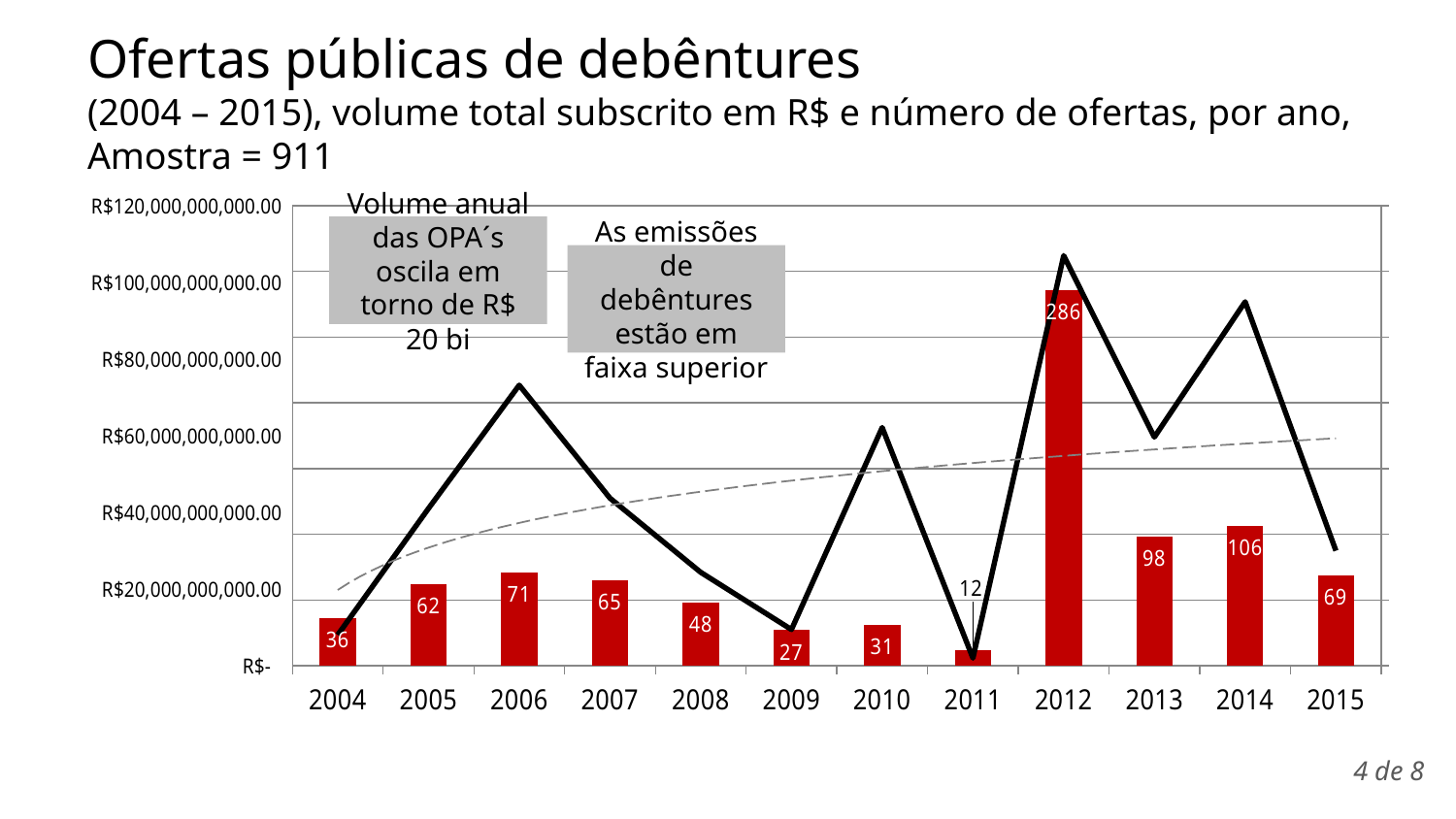
Is the volume line value for 2012 greater or less than R$100,000,000,000.00? greater What is the number of offers labelled on the bar for 2012? 286 What is the number of offers labelled on the bar for 2014? 106 How many years are shown on the x axis? 12 What is the number of offers labelled on the bar for 2004? 36 What kind of chart is shown on the slide? Combination bar and line chart What is the difference between the bar labels for 2012 and 2011? 274 What is the difference between the bar labels for 2014 and 2013? 8 Which year has a larger bar label, 2006 or 2007? 2006 Which year has the lowest bar (number of offers)? 2011 Which year has the highest bar (number of offers)? 2012 Is the volume line value for 2011 greater or less than R$20,000,000,000.00? less